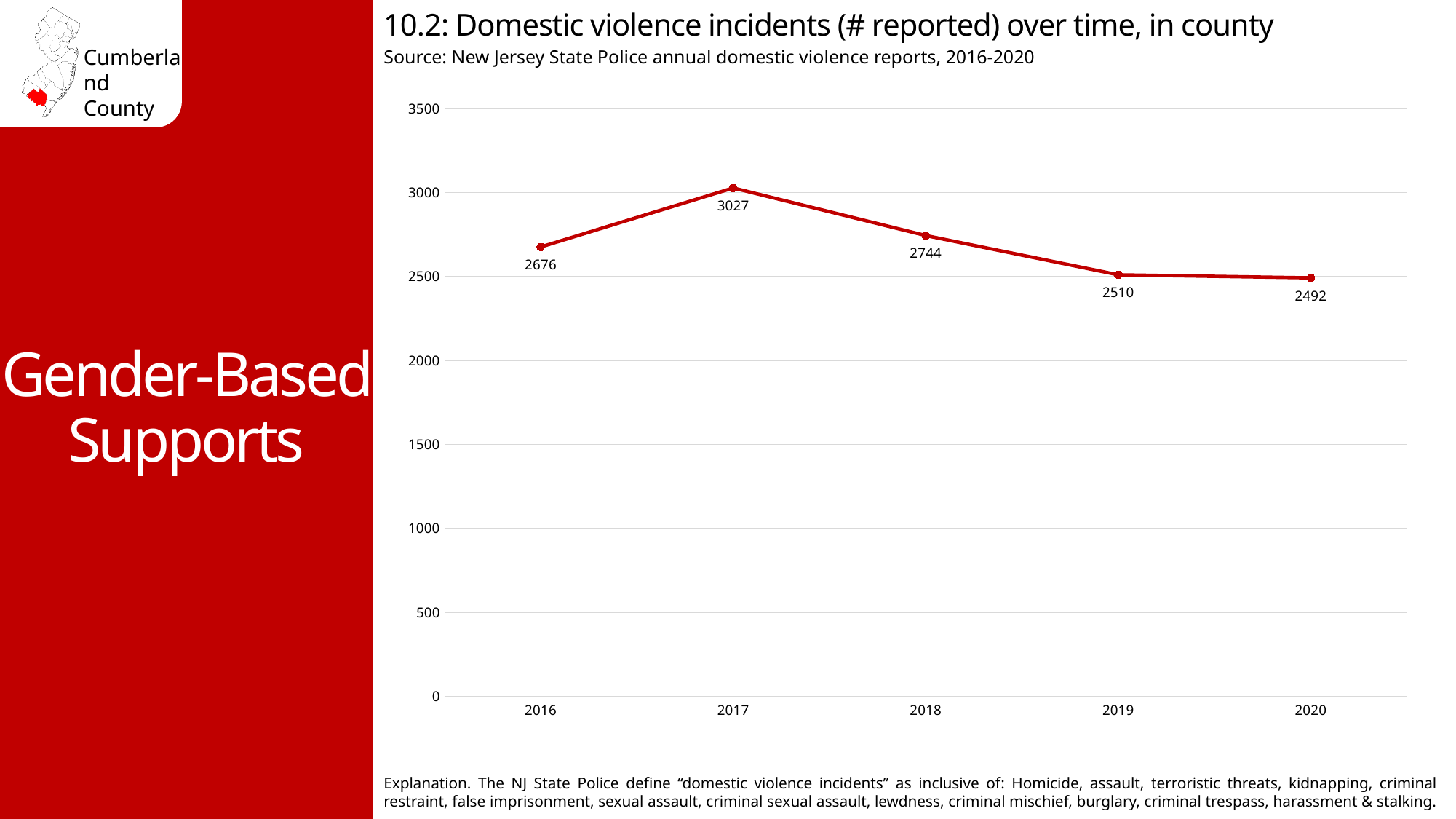
What is the difference between the 2016 and 2020 values? 184 How many domestic violence incidents were reported in 2017? 3027 Which year had more reported incidents, 2018 or 2019? 2018 What is the difference between the 2017 and 2018 values? 283 How many years are plotted on the chart? 5 Do the values rise or fall from 2017 to 2020? fall How many domestic violence incidents were reported in 2020? 2492 Which year had the highest number of reported domestic violence incidents? 2017 Is the value for 2019 greater or less than 3000? less What kind of chart is shown on the slide? line chart What is the value for 2016? 2676 Which year had the lowest number of reported domestic violence incidents? 2020